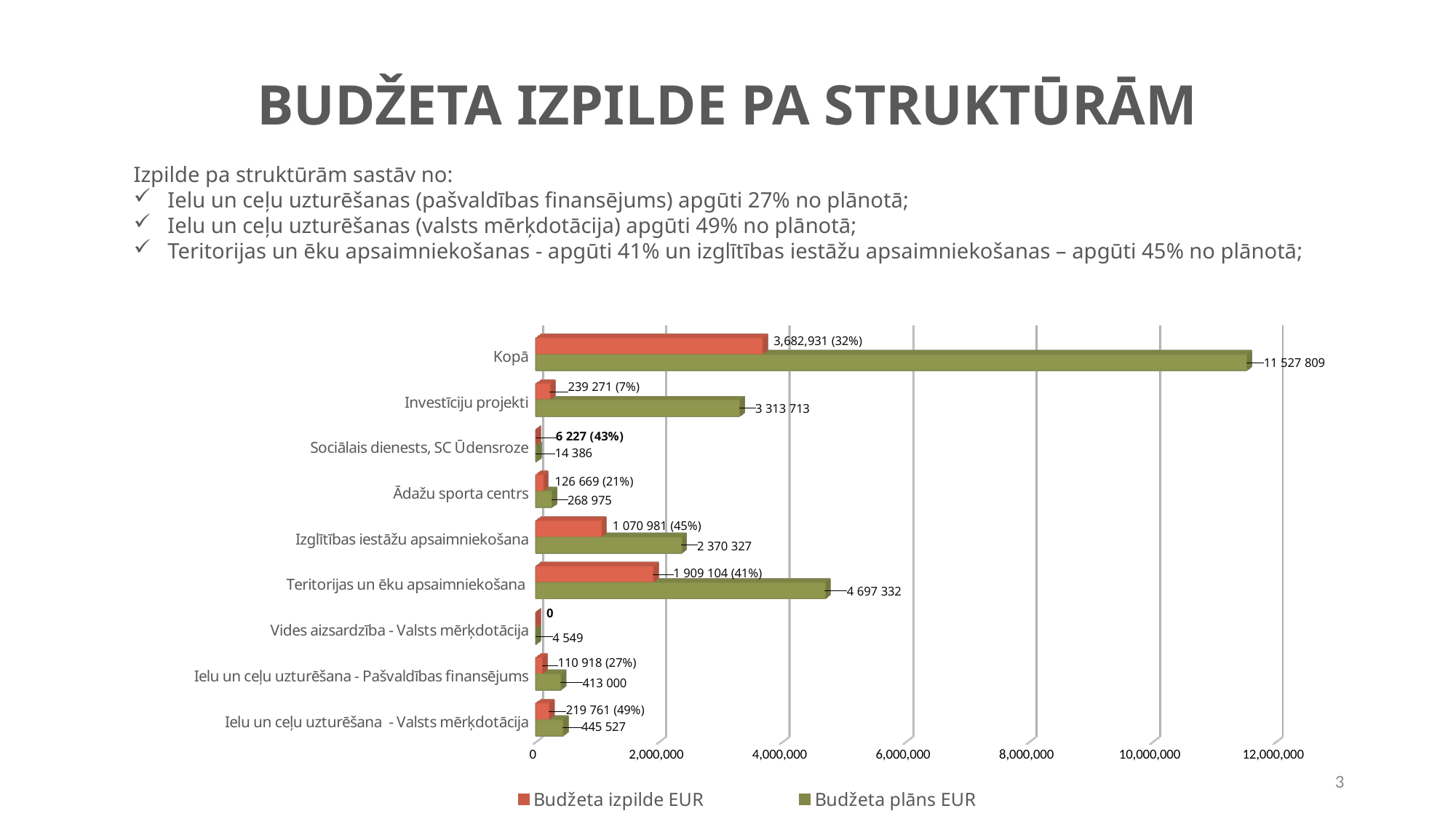
What is the difference between the Budžeta plāns EUR and Budžeta izpilde EUR values for Ielu un ceļu uzturēšana - Pašvaldības finansējums? 302 082 What is the Budžeta izpilde EUR value for Vides aizsardzība - Valsts mērķdotācija? 0 Which category has the highest Budžeta izpilde EUR value? Kopā Is the Budžeta plāns EUR value for Teritorijas un ēku apsaimniekošana greater or less than 4,000,000? greater What is the Budžeta plāns EUR value for Investīciju projekti? 3 313 713 Which is larger: the Budžeta plāns EUR value for Izglītības iestāžu apsaimniekošana or for Teritorijas un ēku apsaimniekošana? Teritorijas un ēku apsaimniekošana How many series does the legend list? 2 What is the Budžeta izpilde EUR value for Teritorijas un ēku apsaimniekošana? 1 909 104 (41%) Which category has the lowest Budžeta plāns EUR value? Vides aizsardzība - Valsts mērķdotācija What is the Budžeta plāns EUR value for Kopā? 11 527 809 How many categories are shown on the chart? 9 What kind of chart is shown on the slide? bar chart